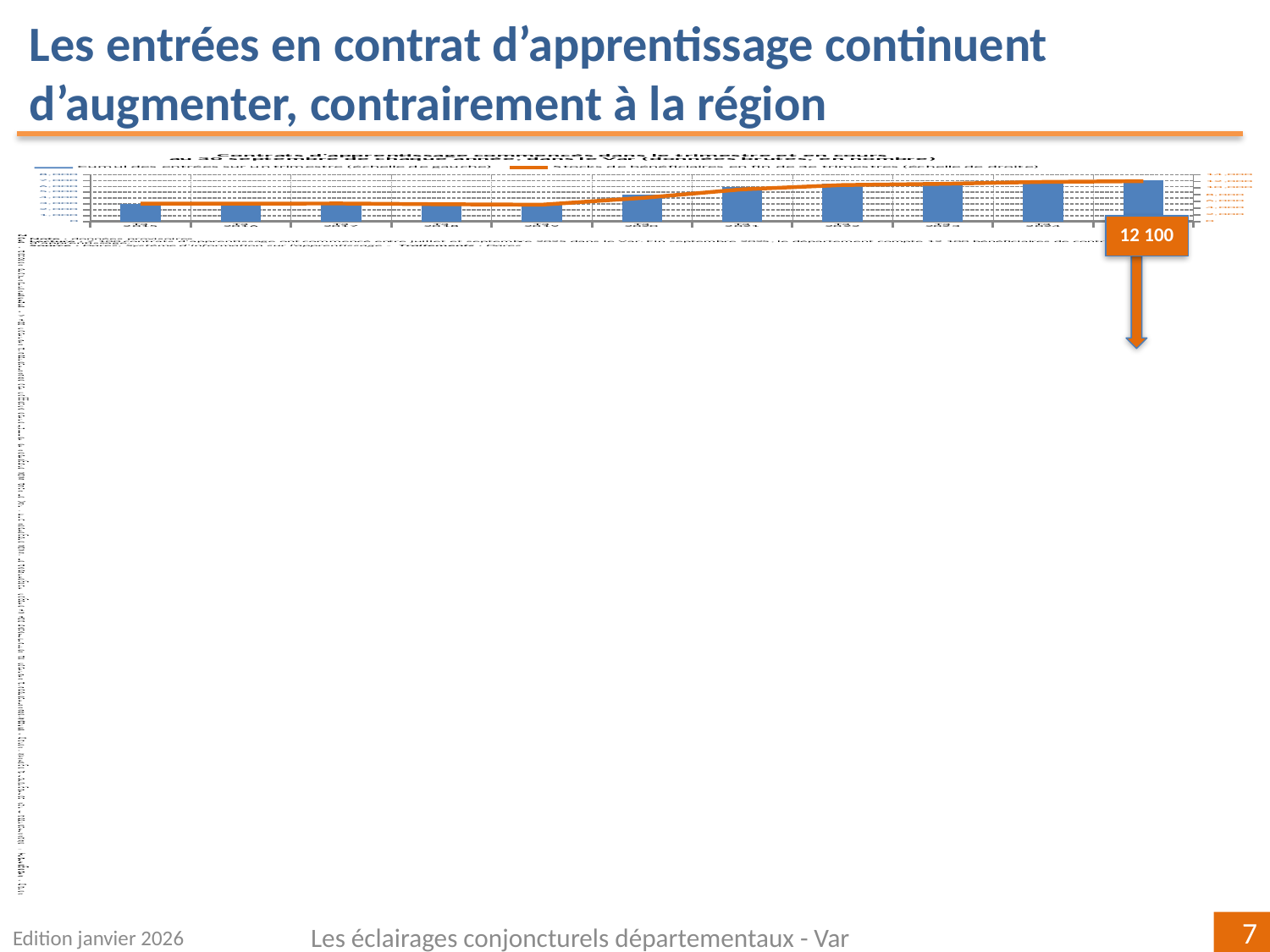
How many series does the chart's legend list? 2 What kind of chart is shown on the slide? A bar chart combined with a line Do the blue bars generally rise or fall from left to right along the x axis? Rise Does the orange line generally rise or fall from left to right? Rise Is the rightmost bar taller or shorter than the leftmost bar? Taller Which colour represents the series 'Stocks de bénéficiaires en fin de ce trimestre' in the chart? Orange Which bar in the chart is the highest? The rightmost (last) bar What value is shown in the orange callout box pointing at the right end of the chart? 12 100 Which colour represents the series 'Cumul des entrées sur un trimestre' in the chart? Blue